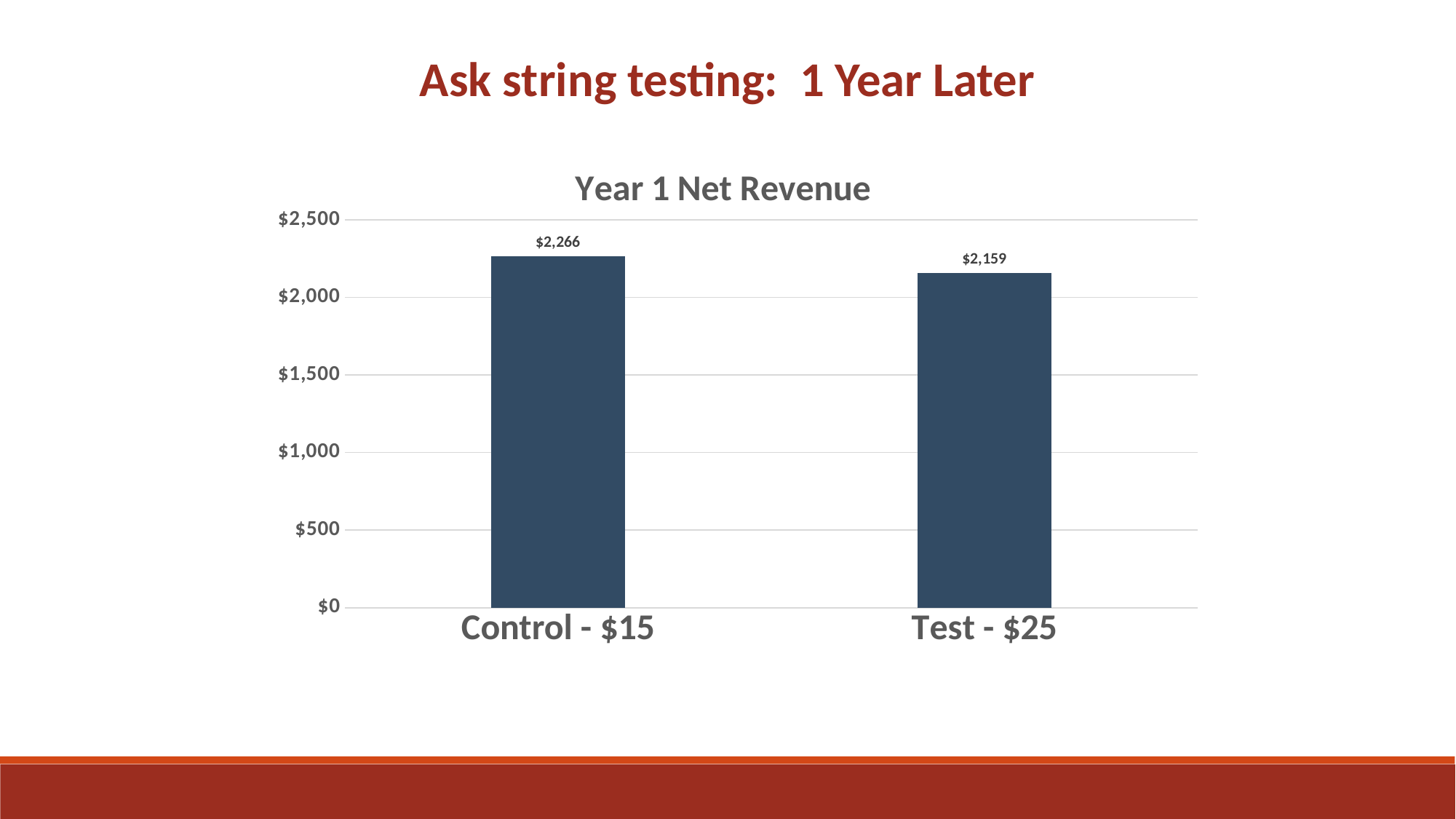
Is the value for Control - $15 greater or less than $2,500? less Which category has the lowest Year 1 Net Revenue? Test - $25 What is the difference in Year 1 Net Revenue between Control - $15 and Test - $25? $107 What is the Year 1 Net Revenue for Control - $15? $2,266 How many categories are shown in the chart? 2 Is the value for Test - $25 greater or less than $2,000? greater Which category has the highest Year 1 Net Revenue? Control - $15 What is the highest value shown on the y axis? $2,500 What is the title of the chart? Year 1 Net Revenue Which has a larger Year 1 Net Revenue, Control - $15 or Test - $25? Control - $15 What is the Year 1 Net Revenue for Test - $25? $2,159 What kind of chart is shown on the slide? bar chart